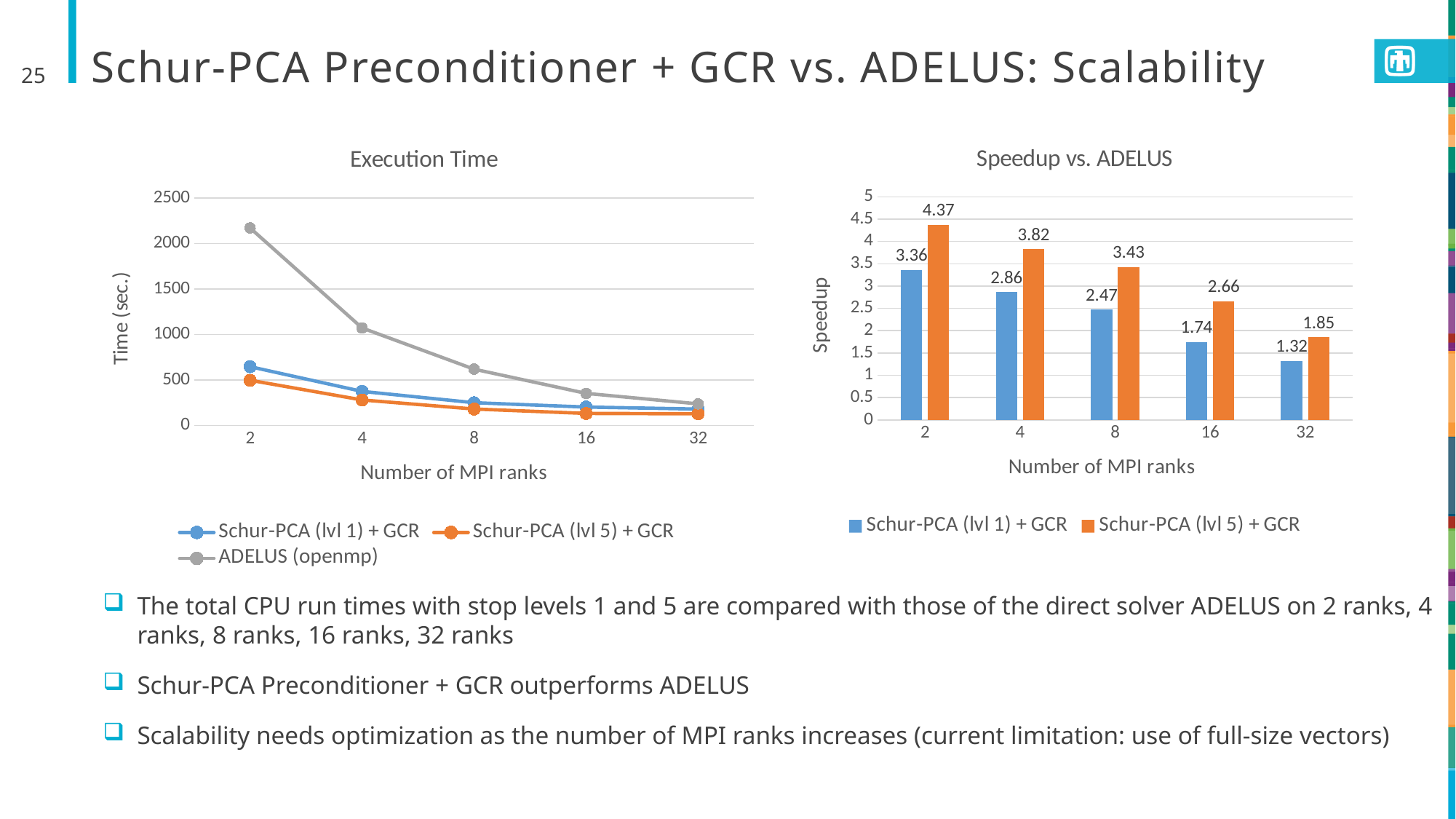
What kind of chart is the Execution Time chart? Line chart In the Speedup vs. ADELUS chart, which series has the larger speedup at 4 MPI ranks? Schur-PCA (lvl 5) + GCR In the Speedup vs. ADELUS chart, at which number of MPI ranks is the Schur-PCA (lvl 1) + GCR speedup highest? 2 In the Execution Time chart, is the value for ADELUS (openmp) at 2 MPI ranks greater or less than 2000? greater How many series does the legend of the Speedup vs. ADELUS chart list? 2 How many series does the legend of the Execution Time chart list? 3 In the Execution Time chart, is the value for Schur-PCA (lvl 1) + GCR at 2 MPI ranks greater or less than 500? greater In the Speedup vs. ADELUS chart, at which number of MPI ranks is the Schur-PCA (lvl 5) + GCR speedup lowest? 32 In the Speedup vs. ADELUS chart, what is the speedup for Schur-PCA (lvl 5) + GCR at 2 MPI ranks? 4.37 In the Speedup vs. ADELUS chart, what is the speedup for Schur-PCA (lvl 1) + GCR at 16 MPI ranks? 1.74 In the Speedup vs. ADELUS chart, what is the difference between the Schur-PCA (lvl 5) + GCR and Schur-PCA (lvl 1) + GCR speedups at 8 MPI ranks? 0.96 In the Speedup vs. ADELUS chart, how does the speedup change as the number of MPI ranks increases? It falls